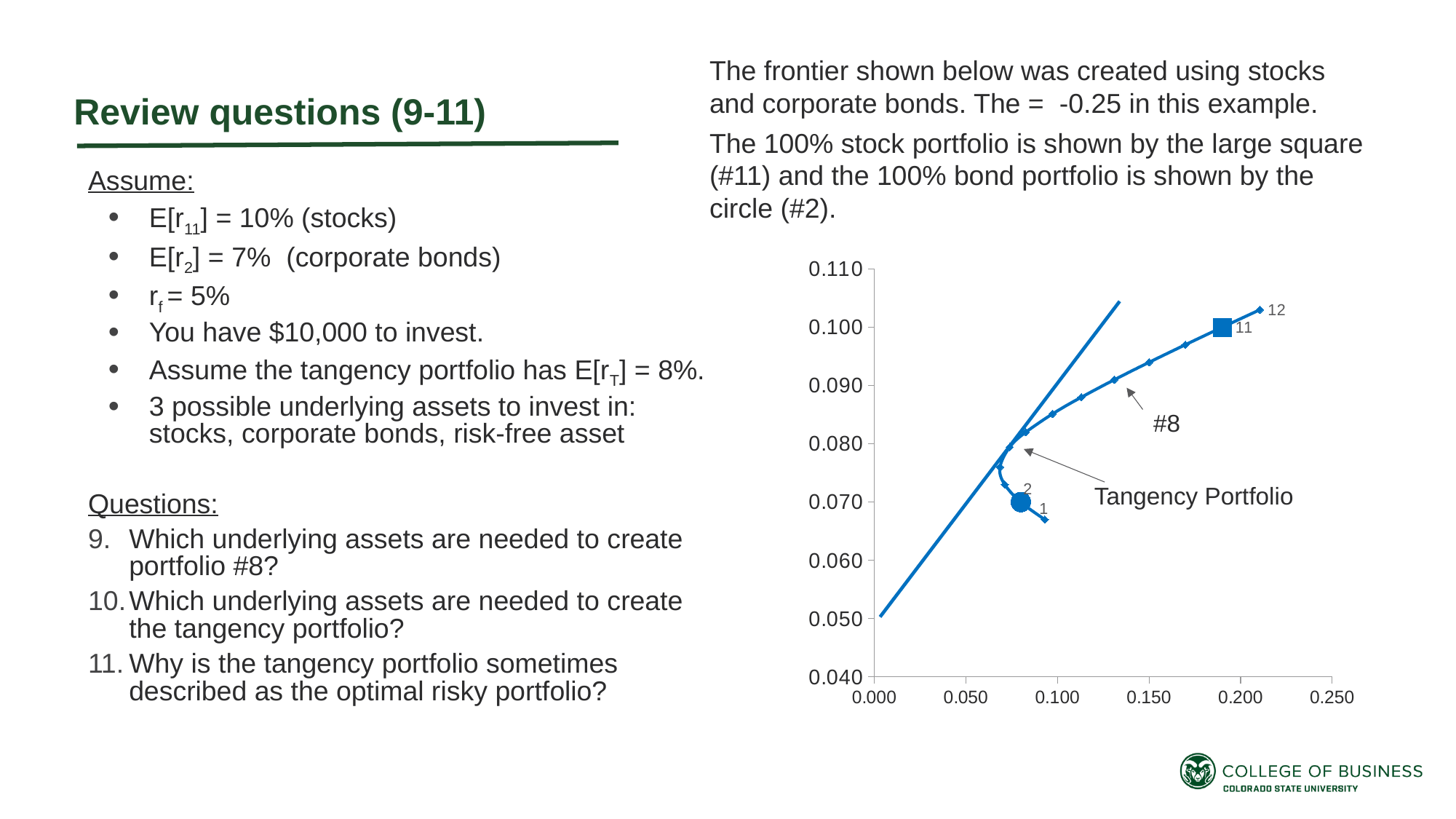
Of the numbered points on the chart, which has the highest y-axis value? 12 What is the y-axis value of the large square marker labeled 11? 0.100 Which marker shape on the chart represents the 100% stock portfolio? The large square (#11) Is the y-axis value of point 12 greater or less than 0.100? greater Is the x-axis value of point 11 greater or less than 0.200? less What kind of chart is shown on the slide? Line chart (XY scatter with lines) Is the y-axis value of point 1 greater or less than 0.070? less Which has the higher y-axis value, point 1 or point 2? Point 2 Of the numbered points on the chart, which has the lowest y-axis value? 1 Which has the higher y-axis value, point 11 or point 12? Point 12 What is the y-axis value of the large circle marker labeled 2? 0.070